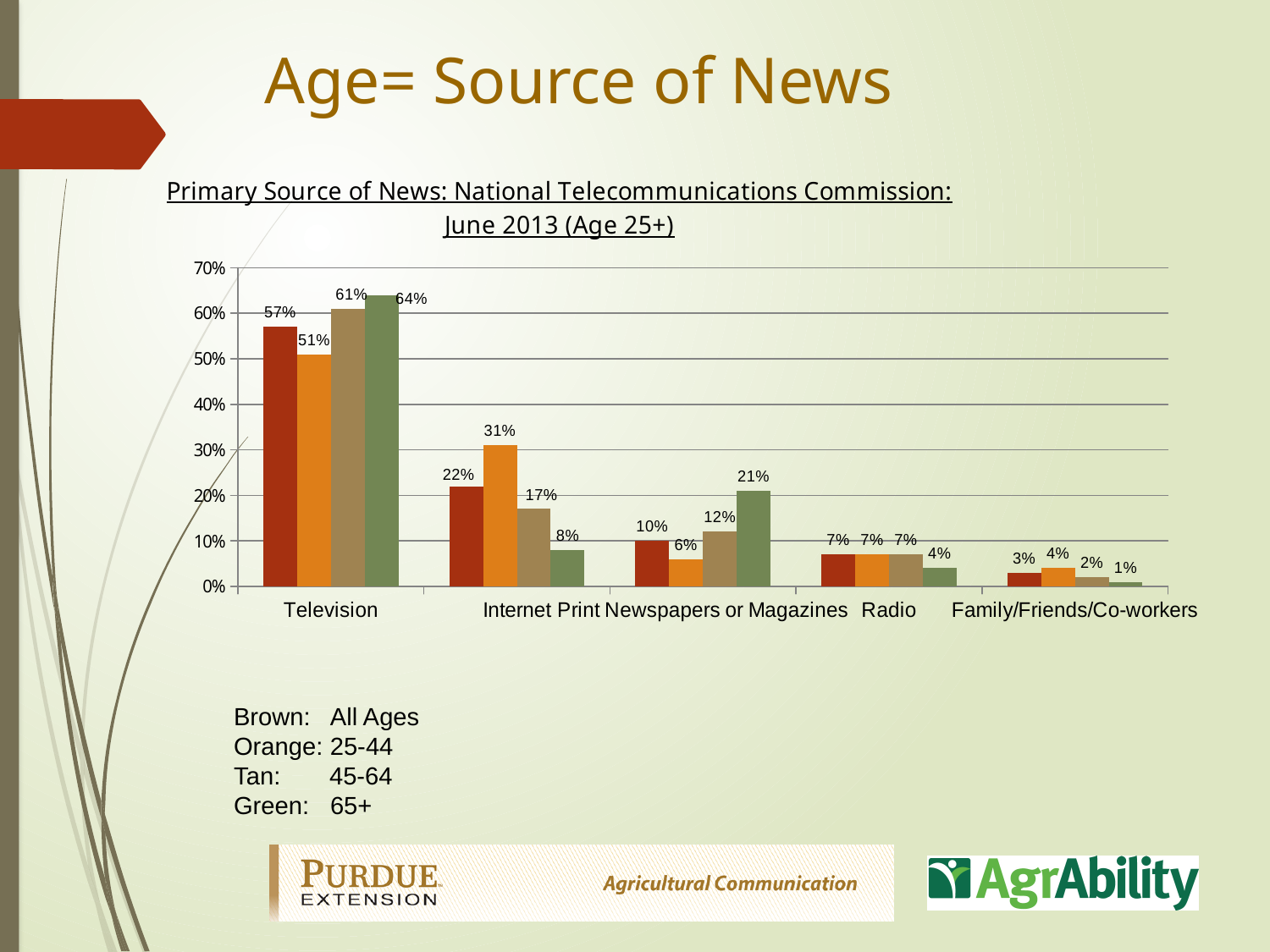
What is the value for Television for the 65+ (green) group? 64% How many age groups (series) are plotted in the chart? 4 Which news source has the highest value for the All Ages (brown) group? Television What is the value for Radio for the All Ages (brown) group? 7% What is the difference between the 25-44 (orange) and 65+ (green) values for Internet? 23% Which news source has the lowest value for the 65+ (green) group? Family/Friends/Co-workers What type of chart is shown on the slide? Bar chart How many news source categories are shown on the x axis? 5 What is the value for Internet for the 25-44 (orange) group? 31% Which colour represents the 45-64 age group? Tan For Television, which is larger: the 25-44 (orange) value or the 45-64 (tan) value? 45-64 (tan) What is the value for Print Newspapers or Magazines for the 65+ (green) group? 21%